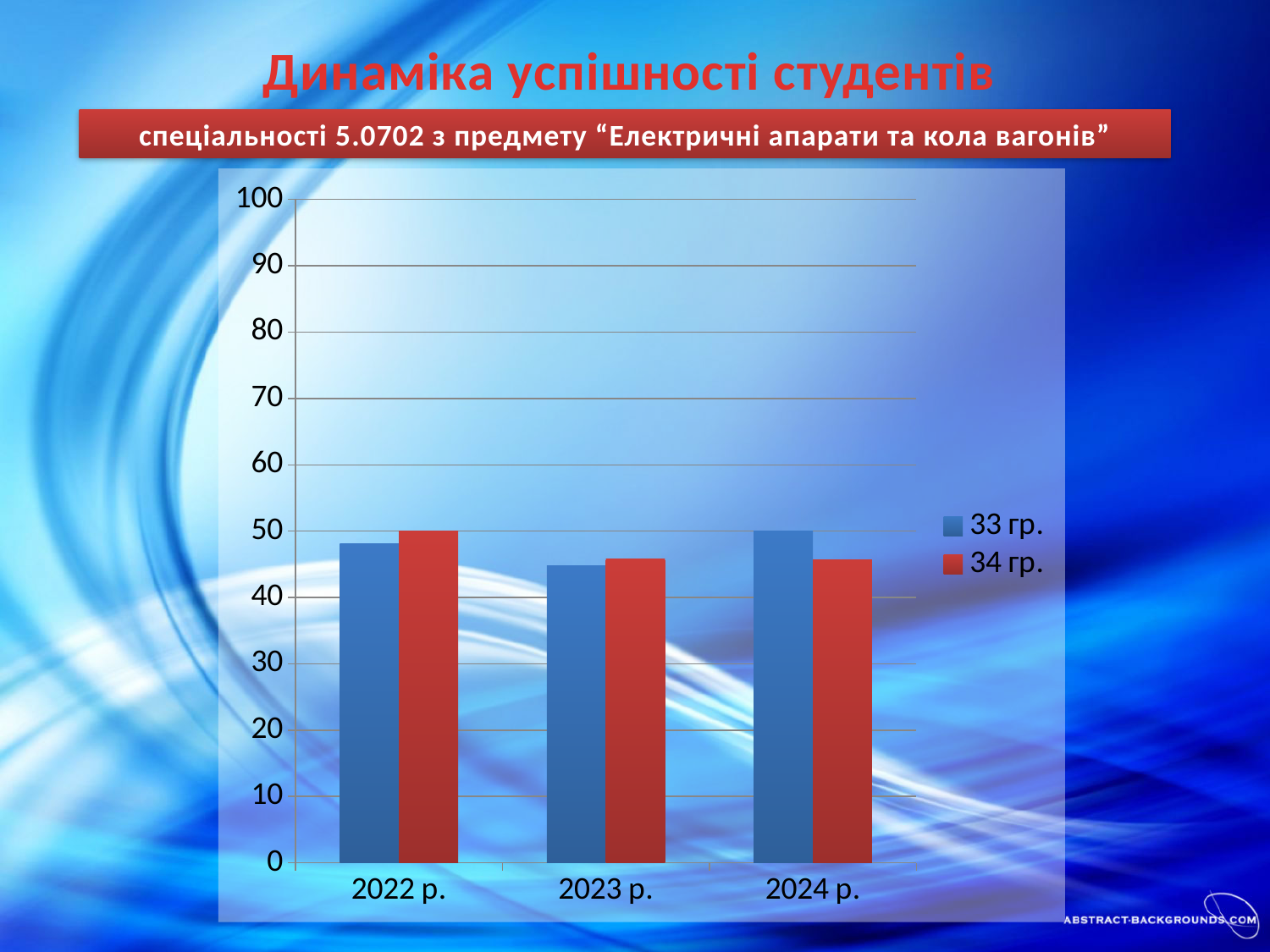
What is the value for 33 гр. in 2024 р.? 50 How many series does the legend list? 2 In 2024 р., which series has the larger value, 33 гр. or 34 гр.? 33 гр. In which year is the value for 33 гр. the highest? 2024 р. What are the two series named in the legend? 33 гр. and 34 гр. In which year is the value for 34 гр. the highest? 2022 р. Is the value for 34 гр. in 2024 р. greater or less than 40? greater Is the value for 33 гр. in 2023 р. greater or less than 50? less How many year categories are shown on the x axis? 3 What kind of chart is shown on the slide? bar chart Is the value for 33 гр. in 2022 р. greater or less than 50? less What is the value for 34 гр. in 2022 р.? 50